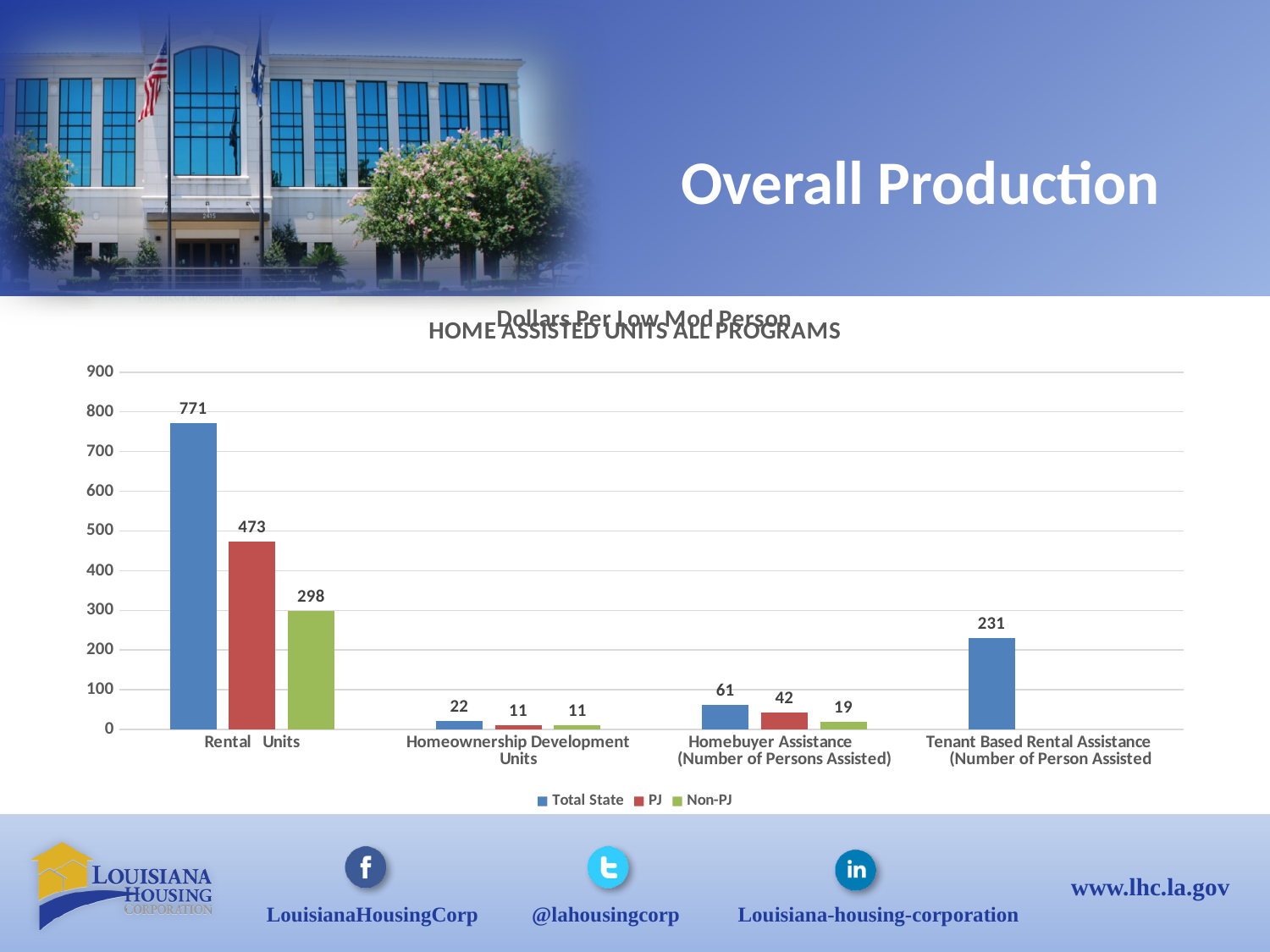
Which is larger, the Non-PJ value for Rental Units or the Total State value for Tenant Based Rental Assistance? Non-PJ value for Rental Units Which category has the highest Total State value? Rental Units What is the PJ value for Rental Units? 473 What is the Non-PJ value for Homebuyer Assistance (Number of Persons Assisted)? 19 How many series does the legend list? 3 What is the difference between the Total State and Non-PJ values for Homebuyer Assistance (Number of Persons Assisted)? 42 What is the difference between the Total State and PJ values for Rental Units? 298 What type of chart is shown on the slide? Bar chart What is the Total State value for Tenant Based Rental Assistance (Number of Person Assisted)? 231 What is the Total State value for Rental Units? 771 How many categories are shown on the x axis? 4 Which category has the lowest Total State value? Homeownership Development Units